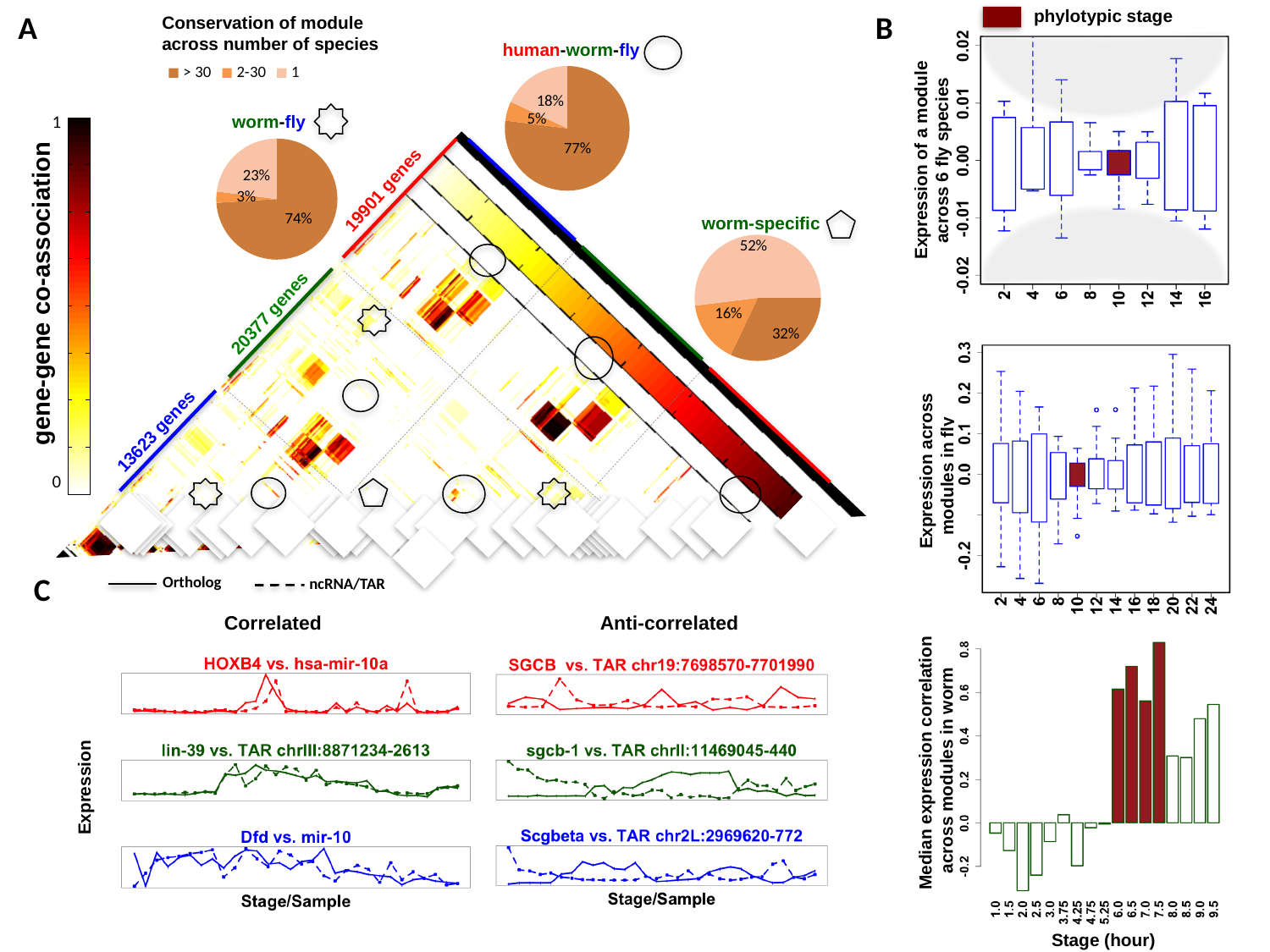
What kind of chart is the bottom chart in panel B (median expression correlation across modules in worm)? bar chart In the bottom chart of panel B, is the value for stage 9.5 hours greater or less than 0.4? greater How many conservation categories does the pie chart legend list? 3 In the human-worm-fly pie chart, which conservation category has the largest slice? > 30 In the worm-fly pie chart, what percentage of modules are conserved across more than 30 species? 74% In the bottom chart of panel B, how many stage (hour) categories are shown on the x axis? 17 In the worm-specific pie chart, which conservation category has the largest slice? 1 In the worm-specific pie chart, what percentage is shown for the 2-30 species category? 16% How many percentage points larger is the > 30 slice in the human-worm-fly pie chart than the > 30 slice in the worm-fly pie chart? 3 In panel C, what does the dashed line represent according to the legend? ncRNA/TAR Which pie chart has the larger slice for modules conserved in only 1 species: worm-fly or human-worm-fly? worm-fly